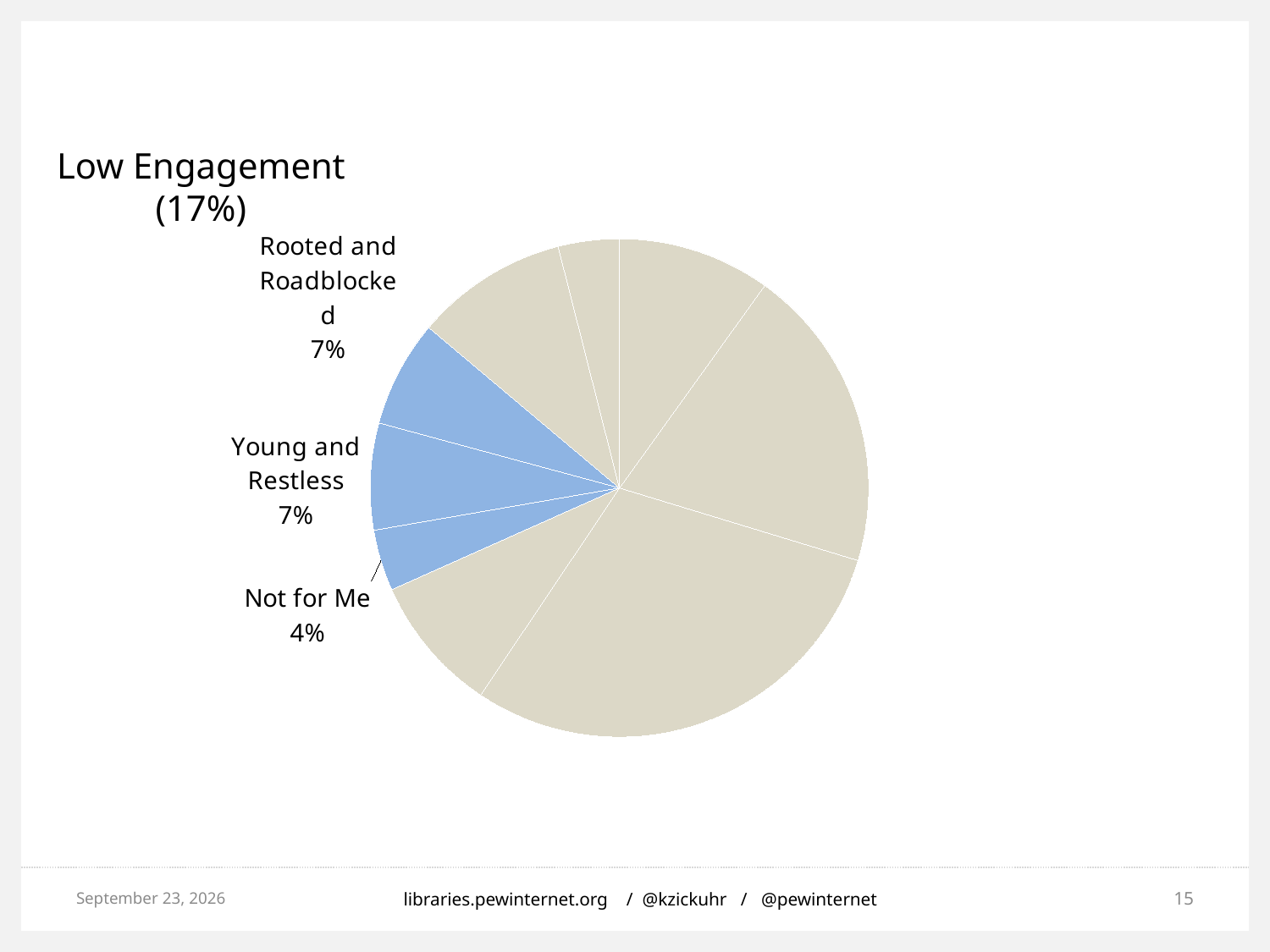
What percentage is shown for the Young and Restless slice? 7% What percentage is shown for the Not for Me slice? 4% What share of the pie does the Not for Me slice represent? 4% What percentage is shown for the Rooted and Roadblocked slice? 7% What is the difference in percentage points between the Young and Restless slice and the Not for Me slice? 3% Are the Rooted and Roadblocked and Young and Restless slices equal in size, or is one larger? They are equal How many slices of the pie have labels with percentages? 3 What colour are the labeled slices (Rooted and Roadblocked, Young and Restless, Not for Me)? Blue What is the title shown above the chart? Low Engagement (17%) Which is larger, the Young and Restless slice or the Not for Me slice? Young and Restless Which of the labeled slices has the smallest share? Not for Me What kind of chart is shown on the slide? Pie chart